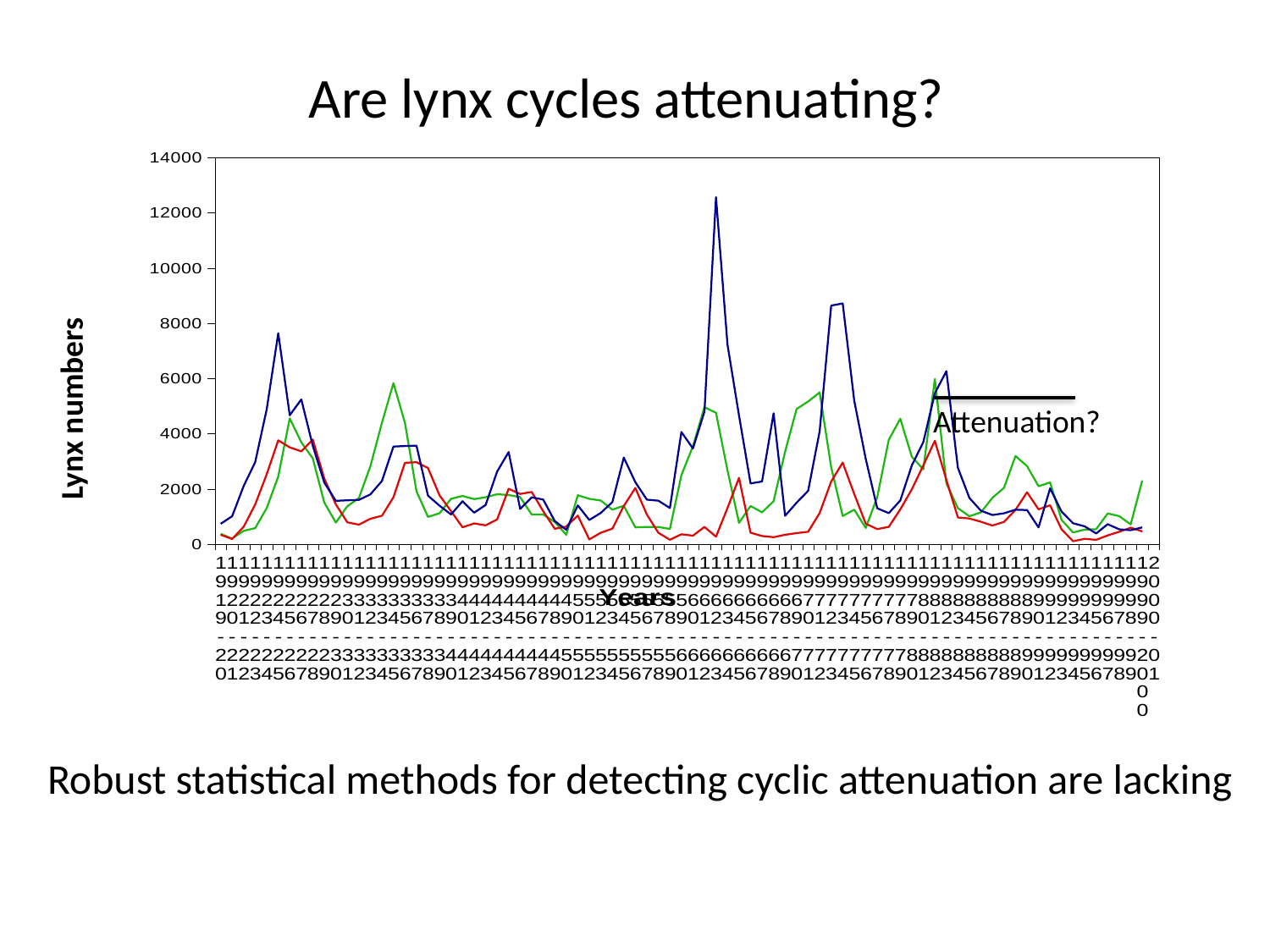
Which coloured line reaches the highest value on the chart? blue How many lines are plotted on the chart? 3 What is the label of the horizontal axis of the chart? Years Is the highest peak of the green line greater or less than 4000? greater What kind of chart is shown on the slide? line chart What annotation text is written near the right side of the chart? Attenuation? Is the highest peak of the blue line greater or less than 12000? greater What is the highest value shown on the vertical axis of the chart? 14000 Which line reaches a higher peak on the chart, the blue line or the red line? blue Is the highest peak of the red line greater or less than 4000? less